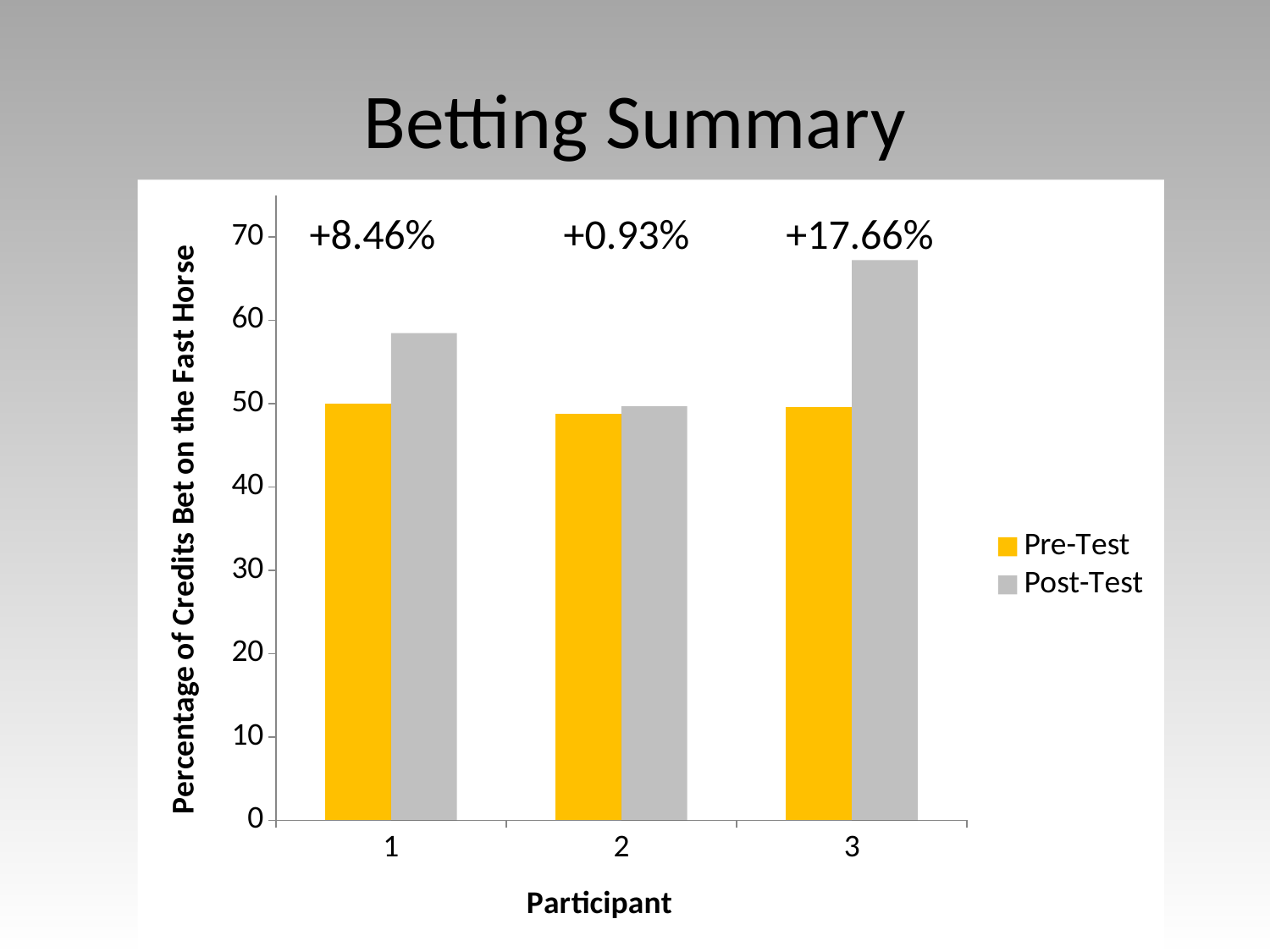
Is the Post-Test value for participant 3 greater or less than 60? greater Is the Pre-Test value for participant 2 greater or less than 50? less How many participants are shown on the x axis? 3 Which participant has the lowest Post-Test value? 2 Is the Post-Test value for participant 1 greater or less than 50? greater Which participant has the highest Post-Test value? 3 What kind of chart is shown on the slide? bar chart Which colour represents the Pre-Test series in the legend? yellow For participant 3, which is larger, the Pre-Test or the Post-Test value? Post-Test What change is printed above the bars for participant 3? +17.66% What is the title of the chart? Betting Summary How many series does the legend list? 2